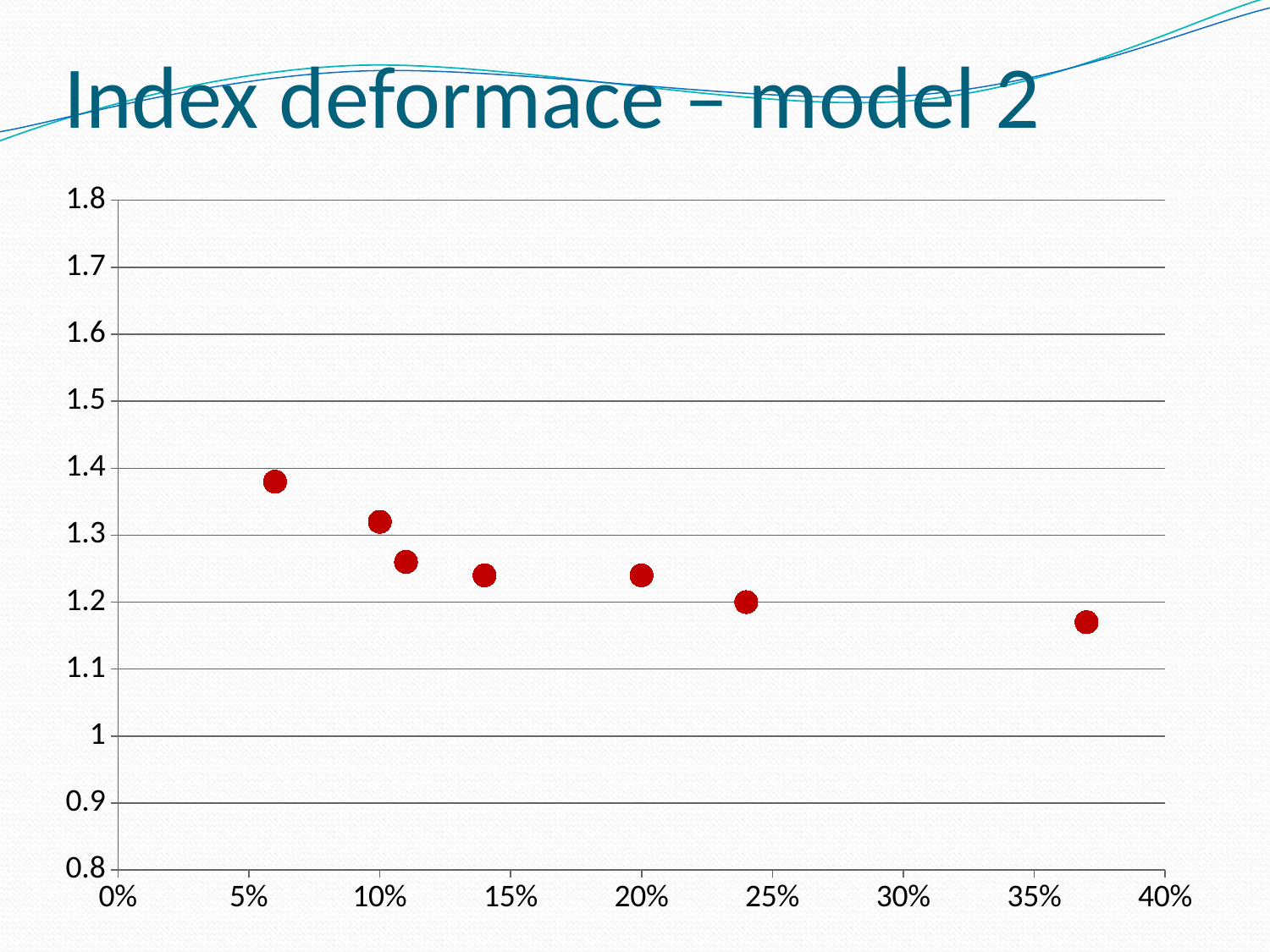
Is the value of the leftmost point (near 6%) greater or less than 1.3? greater What is the title of the slide? Index deformace – model 2 Is the value of the point near 20% greater or less than 1.3? less Do the plotted values rise or fall as the x-axis value increases? fall Which point has the lowest value on the chart? the rightmost point (near 37%) Which point has the highest value: the one near 6% or the one near 37%? the one near 6% What is the maximum value shown on the y-axis? 1.8 What kind of chart is shown on the slide? scatter chart Is the value of the rightmost point (near 37%) greater or less than 1.2? less How many data points are plotted on the chart? 7